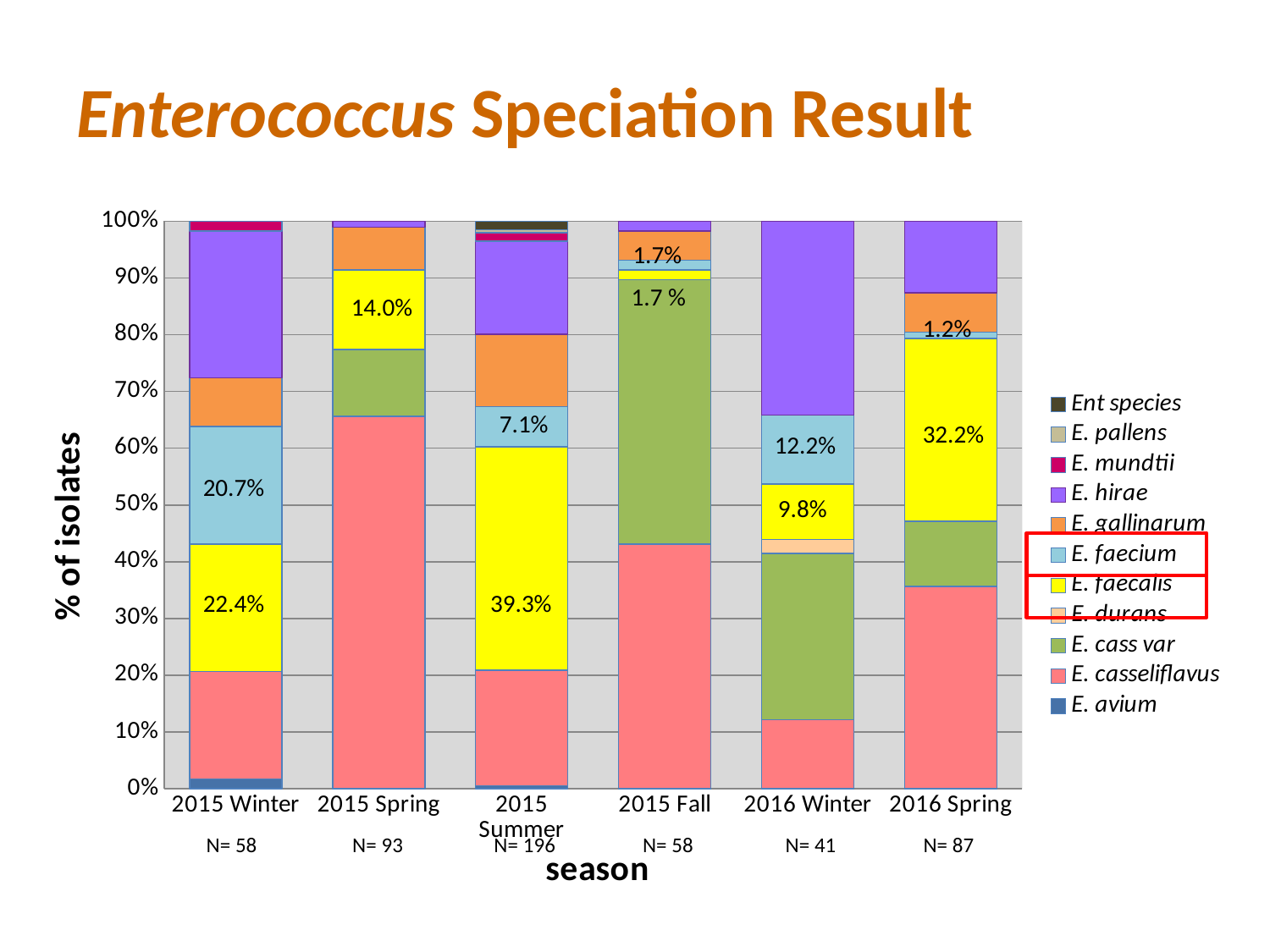
Is the E. casseliflavus share in 2015 Spring greater or less than 60%? greater What percentage of isolates in 2016 Winter were E. faecium? 12.2% What percentage of isolates in 2015 Summer were E. faecalis? 39.3% How many species does the legend list? 11 What is the labelled E. faecium share for 2015 Winter? 20.7% What type of chart is shown on the slide? Stacked bar chart In 2015 Winter, how much larger is the E. faecalis share than the E. faecium share? 1.7% Which season has the highest labelled E. faecalis percentage? 2015 Summer Which season has the lowest labelled E. faecium percentage? 2016 Spring What is the labelled E. faecalis share for 2016 Spring? 32.2% How many seasons are shown on the x axis? 6 In 2016 Winter, which is larger: the E. faecium share or the E. faecalis share? E. faecium